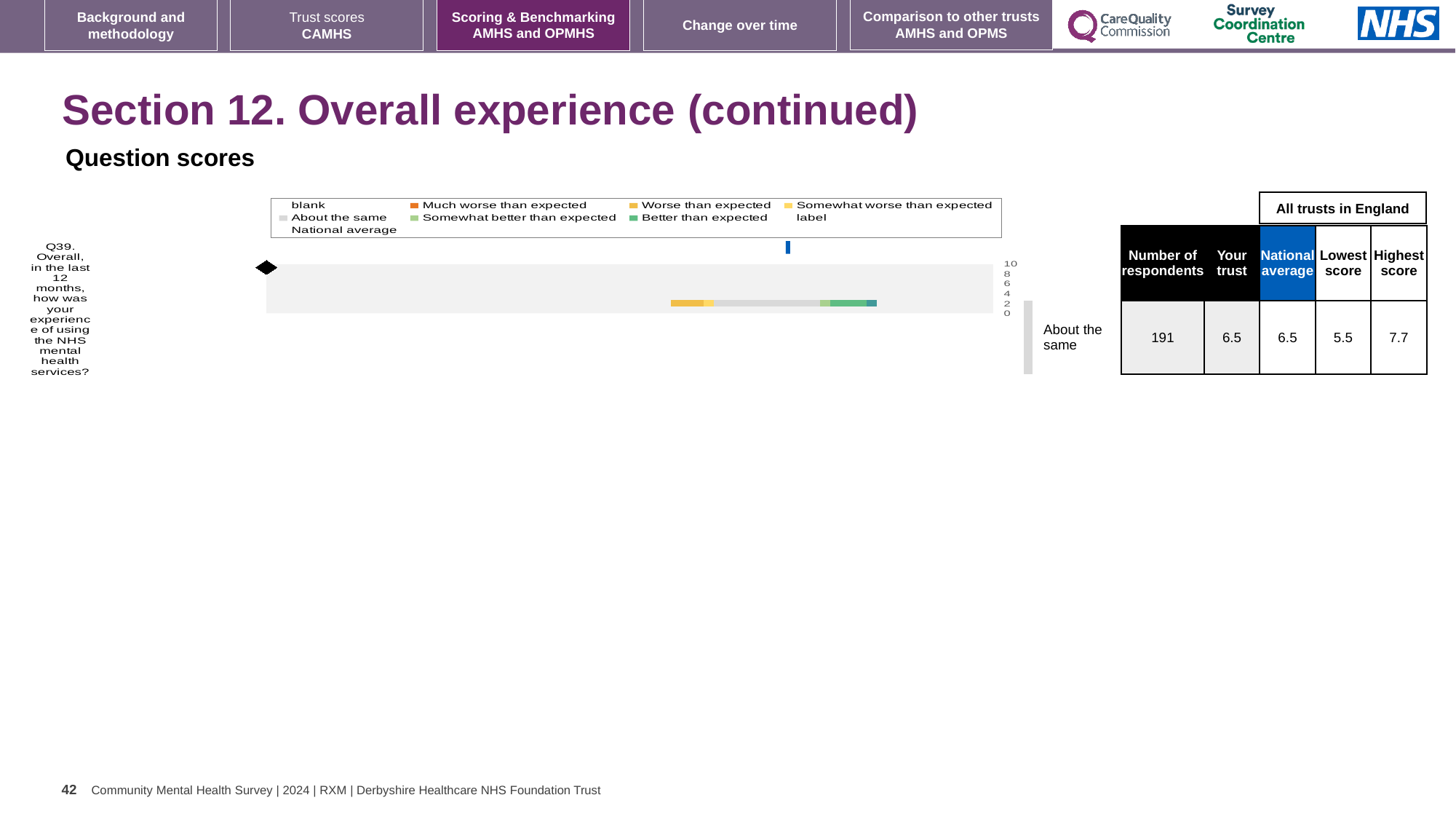
How many entries does the chart legend list? 9 Which benchmark category is the trust's Q39 result labelled as, to the right of the chart? About the same Which question number is plotted in the chart? Q39 How many respondents answered Q39? 191 What is the difference between the highest score and the lowest score for Q39? 2.2 What kind of chart is shown on the slide for Q39? bar chart What is the highest score across all trusts in England for Q39? 7.7 What is the lowest score across all trusts in England for Q39? 5.5 How many survey questions are plotted in the chart? 1 What is the 'Your trust' score for Q39 in the table beside the chart? 6.5 What is the national average score for Q39 shown in the table beside the chart? 6.5